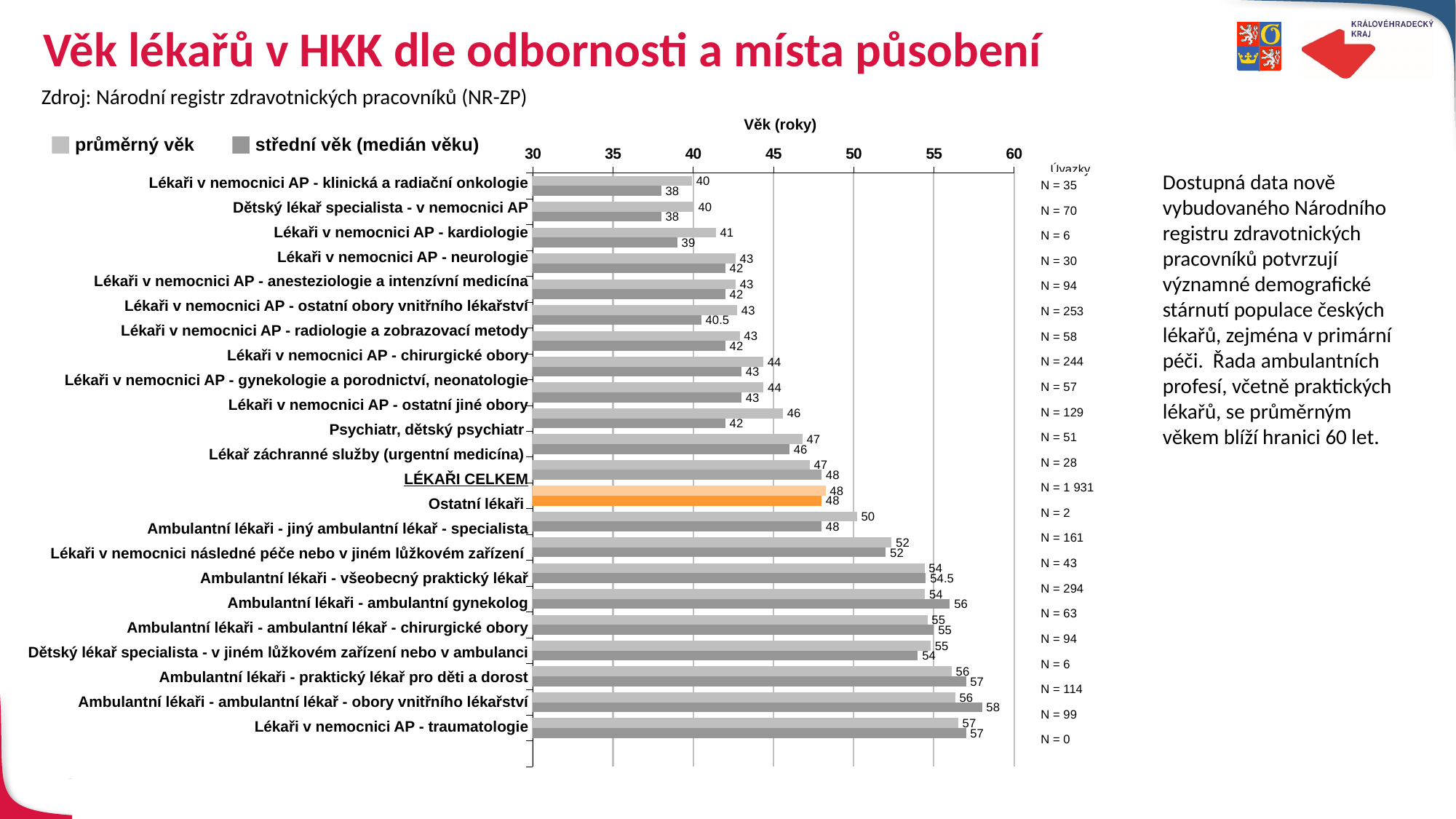
What type of chart is shown on the slide? bar chart What is the průměrný věk for Lékaři v nemocnici AP - kardiologie? 41 Which has a higher průměrný věk: Lékaři v nemocnici AP - chirurgické obory or Lékaři v nemocnici AP - kardiologie? Lékaři v nemocnici AP - chirurgické obory What is the title of the horizontal axis of the chart? Věk (roky) What is the střední věk (medián věku) for Lékaři v nemocnici AP - klinická a radiační onkologie? 38 What is the střední věk (medián věku) for Lékaři v nemocnici AP - ostatní obory vnitřního lékařství? 40.5 What is the difference between the průměrný věk and the střední věk for Lékaři v nemocnici AP - neurologie? 1 How many series does the legend list? 2 Do the průměrný věk values increase or decrease going from the top category to the bottom category of the chart? increase Is the průměrný věk for Lékaři v nemocnici AP - gynekologie a porodnictví, neonatologie greater or less than 50? less What is the difference between the průměrný věk and the střední věk for Lékaři v nemocnici AP - ostatní jiné obory? 4 What is the průměrný věk for Lékaři v nemocnici AP - ostatní jiné obory? 46